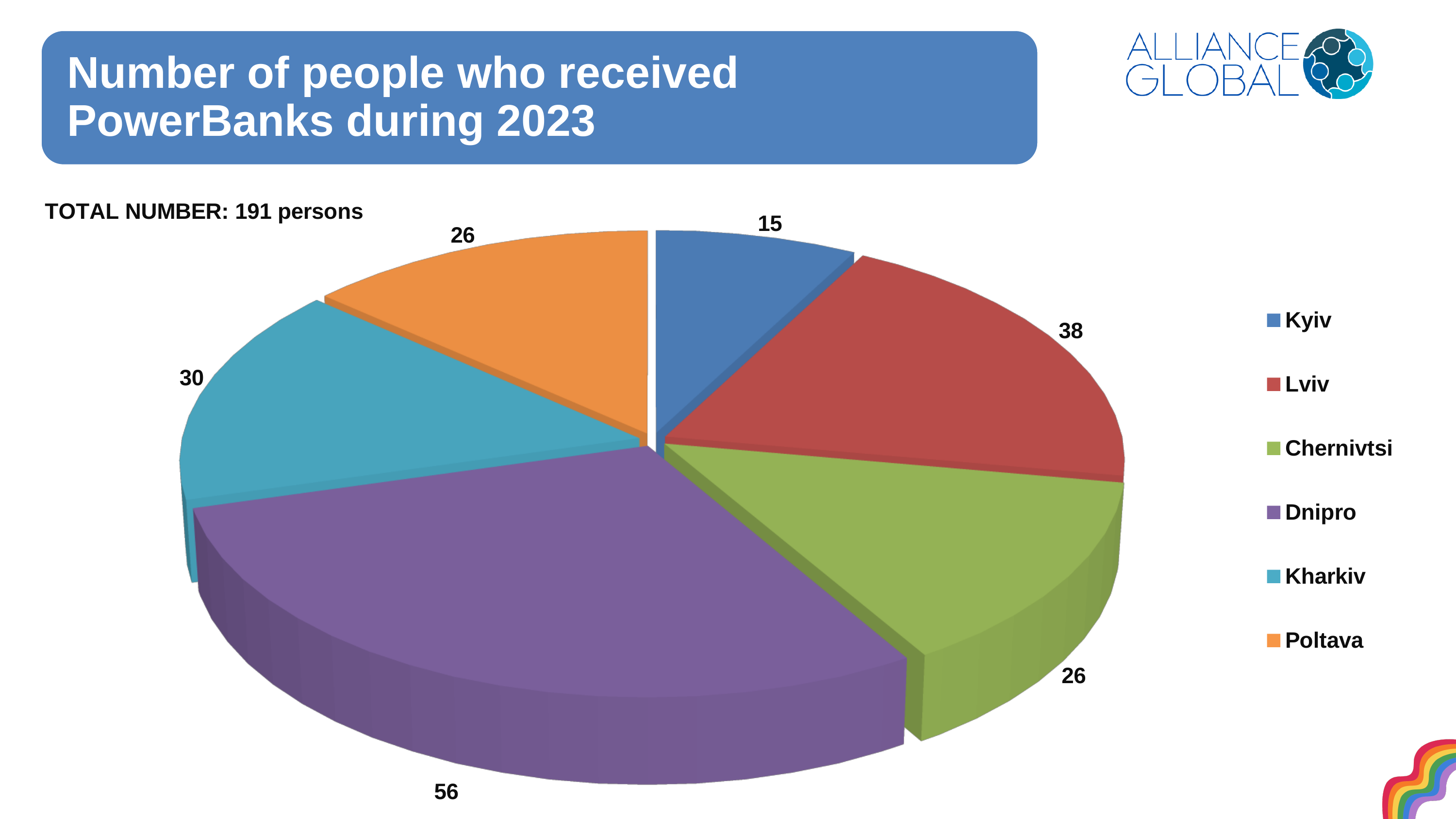
How many people received PowerBanks in Lviv? 38 How many people received PowerBanks in Kharkiv? 30 How many people received PowerBanks in Kyiv? 15 Which city has the smallest number of people who received PowerBanks? Kyiv Which city has more people who received PowerBanks, Kharkiv or Chernivtsi? Kharkiv What type of chart is shown on the slide? pie chart What is the total number of persons stated on the slide? 191 persons Which colour represents Poltava in the pie chart? orange What is the difference between the number of people in Dnipro and in Lviv? 18 Which city has the largest number of people who received PowerBanks? Dnipro How many people received PowerBanks in Dnipro? 56 How many cities are shown in the pie chart? 6